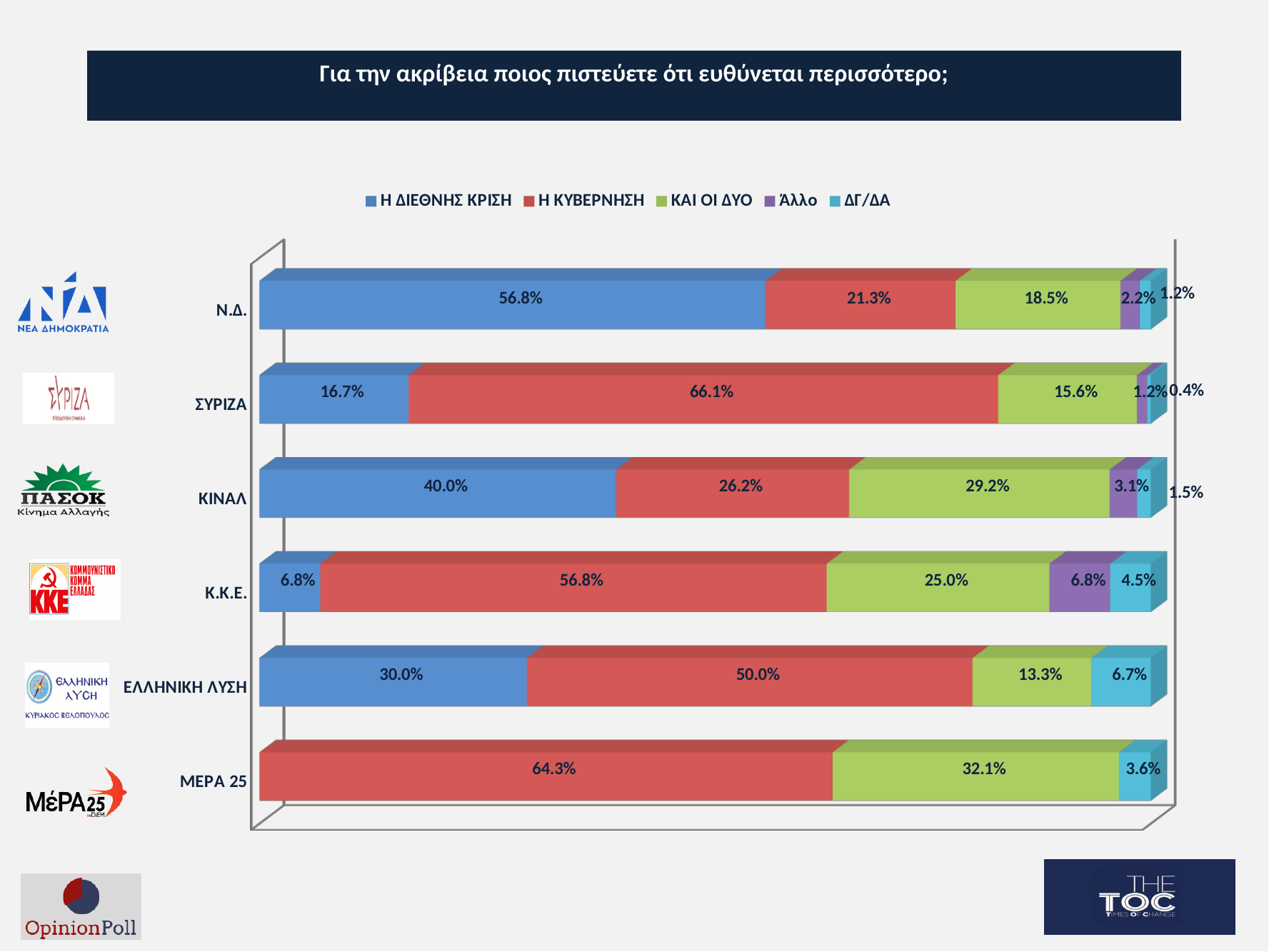
What is the difference between the Η ΚΥΒΕΡΝΗΣΗ value for ΜΕΡΑ 25 and for ΕΛΛΗΝΙΚΗ ΛΥΣΗ? 14.3% Which colour represents ΚΑΙ ΟΙ ΔΥΟ in the legend? Green What is the ΔΓ/ΔΑ value for Κ.Κ.Ε.? 4.5% How many parties are shown on the chart? 6 What percentage of Ν.Δ. voters answered Η ΔΙΕΘΝΗΣ ΚΡΙΣΗ? 56.8% What is the ΚΑΙ ΟΙ ΔΥΟ value for ΚΙΝΑΛ? 29.2% How many series does the legend list? 5 Which party has the highest Η ΔΙΕΘΝΗΣ ΚΡΙΣΗ value? Ν.Δ. Which party has the lowest Η ΚΥΒΕΡΝΗΣΗ value? Ν.Δ. What kind of chart is shown on the slide? Stacked bar chart What percentage of ΣΥΡΙΖΑ voters answered Η ΚΥΒΕΡΝΗΣΗ? 66.1% Which is larger for ΚΙΝΑΛ: Η ΔΙΕΘΝΗΣ ΚΡΙΣΗ or Η ΚΥΒΕΡΝΗΣΗ? Η ΔΙΕΘΝΗΣ ΚΡΙΣΗ